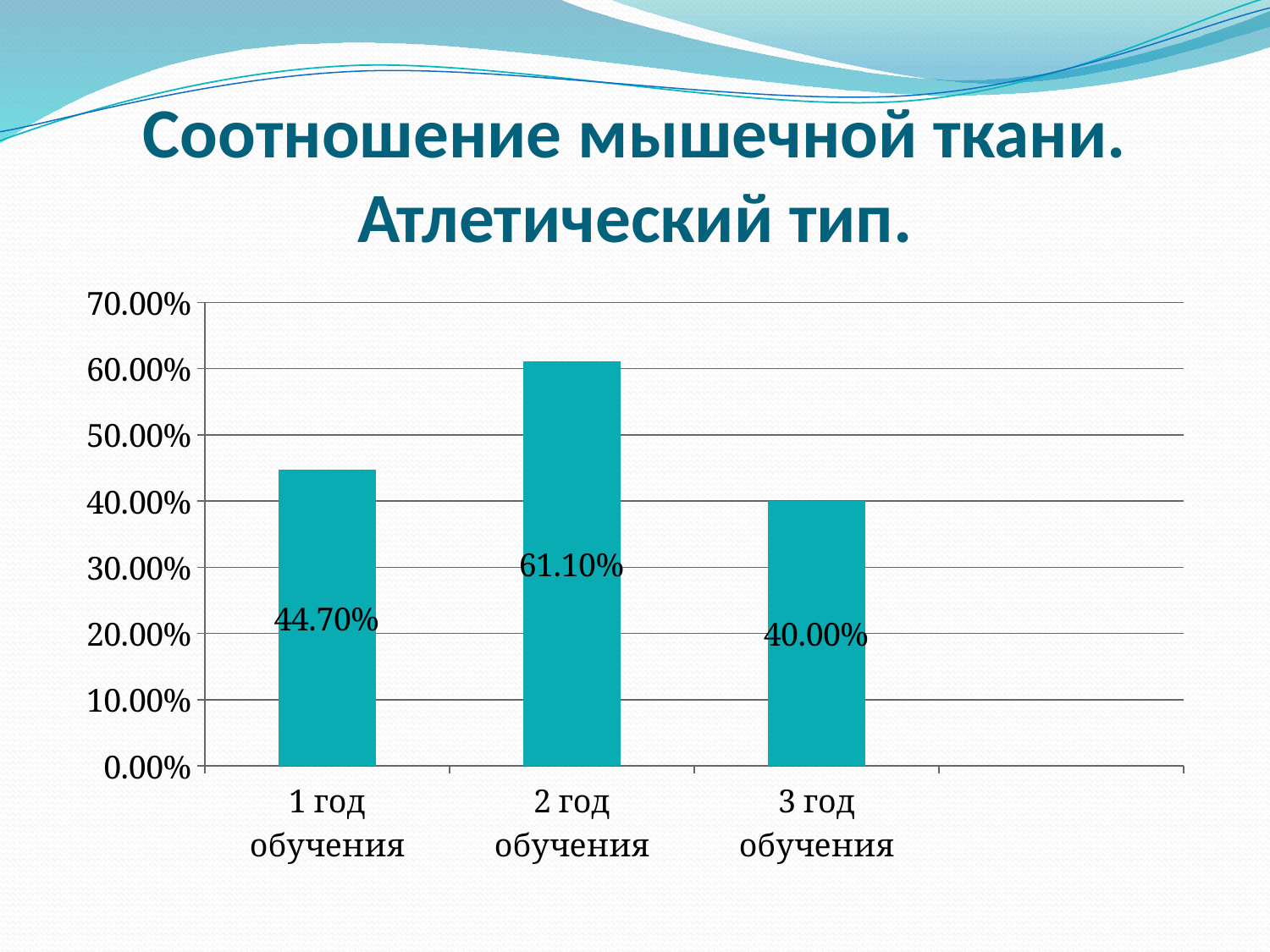
Is the value for 2 год обучения greater or less than 50.00%? greater What is the difference between the values for 1 год обучения and 3 год обучения? 4.70% Which category has the lowest value? 3 год обучения How many categories are shown on the x axis? 3 What is the difference between the values for 2 год обучения and 1 год обучения? 16.40% What is the title of the slide? Соотношение мышечной ткани. Атлетический тип. What is the value for 1 год обучения? 44.70% Which is larger, the value for 1 год обучения or 3 год обучения? 1 год обучения What is the value for 2 год обучения? 61.10% Which category has the highest value? 2 год обучения What kind of chart is shown on the slide? bar chart What is the value for 3 год обучения? 40.00%